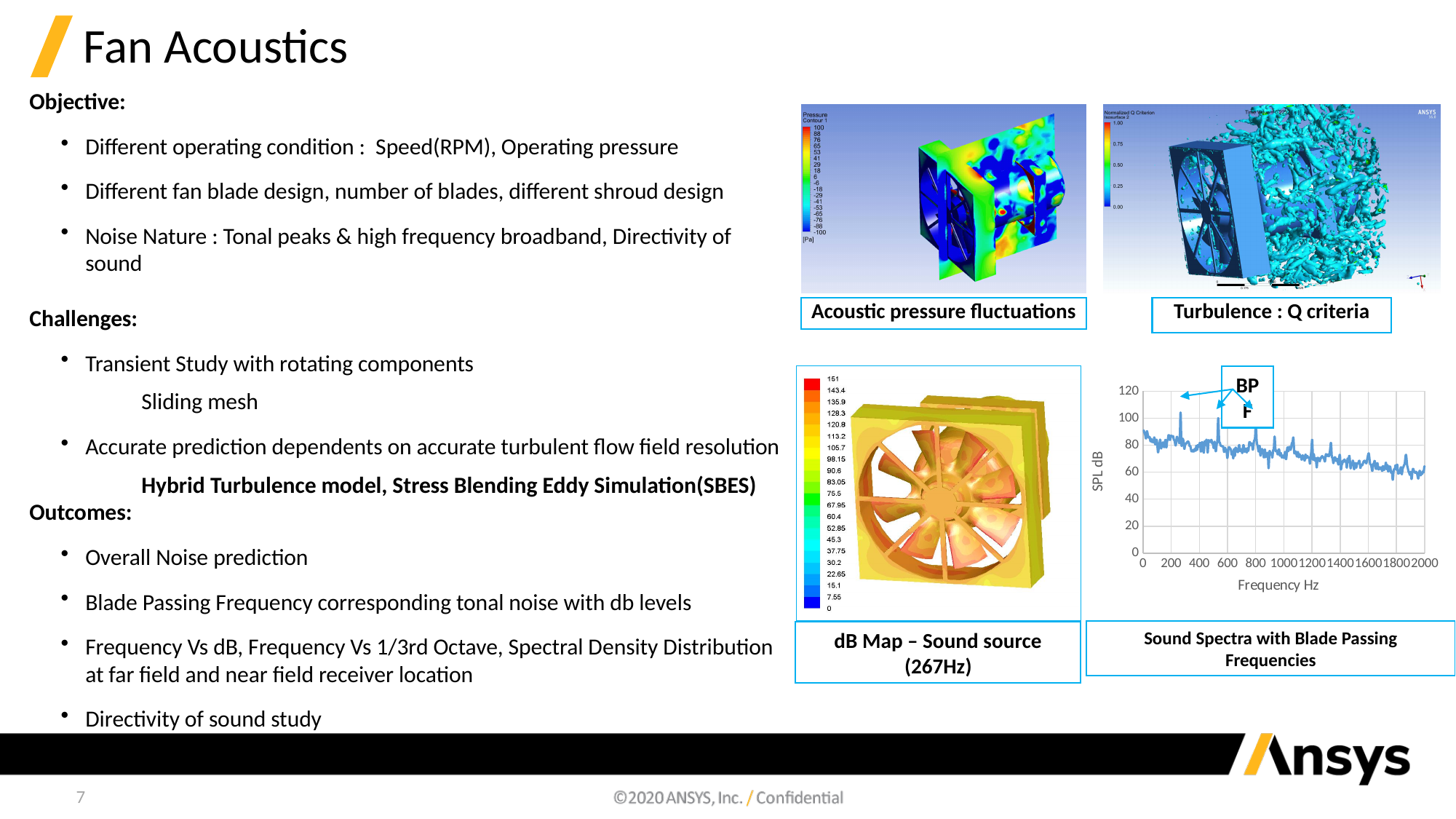
What kind of chart is the 'Sound Spectra with Blade Passing Frequencies' chart? line chart In the 'Sound Spectra with Blade Passing Frequencies' chart, is the SPL value at 0 Hz greater or less than 60? greater In the 'Sound Spectra with Blade Passing Frequencies' chart, do the SPL values generally rise or fall as frequency increases from 0 to 2000 Hz? fall In the 'Sound Spectra with Blade Passing Frequencies' chart, is the SPL value at 1800 Hz greater or less than 100? less In the 'Sound Spectra with Blade Passing Frequencies' chart, is the highest peak near 270 Hz greater or less than 80 dB? greater In the 'Sound Spectra with Blade Passing Frequencies' chart, what is the maximum value shown on the y axis? 120 In the 'Sound Spectra with Blade Passing Frequencies' chart, what is the label of the x axis? Frequency Hz In the 'Sound Spectra with Blade Passing Frequencies' chart, what is the label of the y axis? SPL dB How many data series are plotted in the 'Sound Spectra with Blade Passing Frequencies' chart? 1